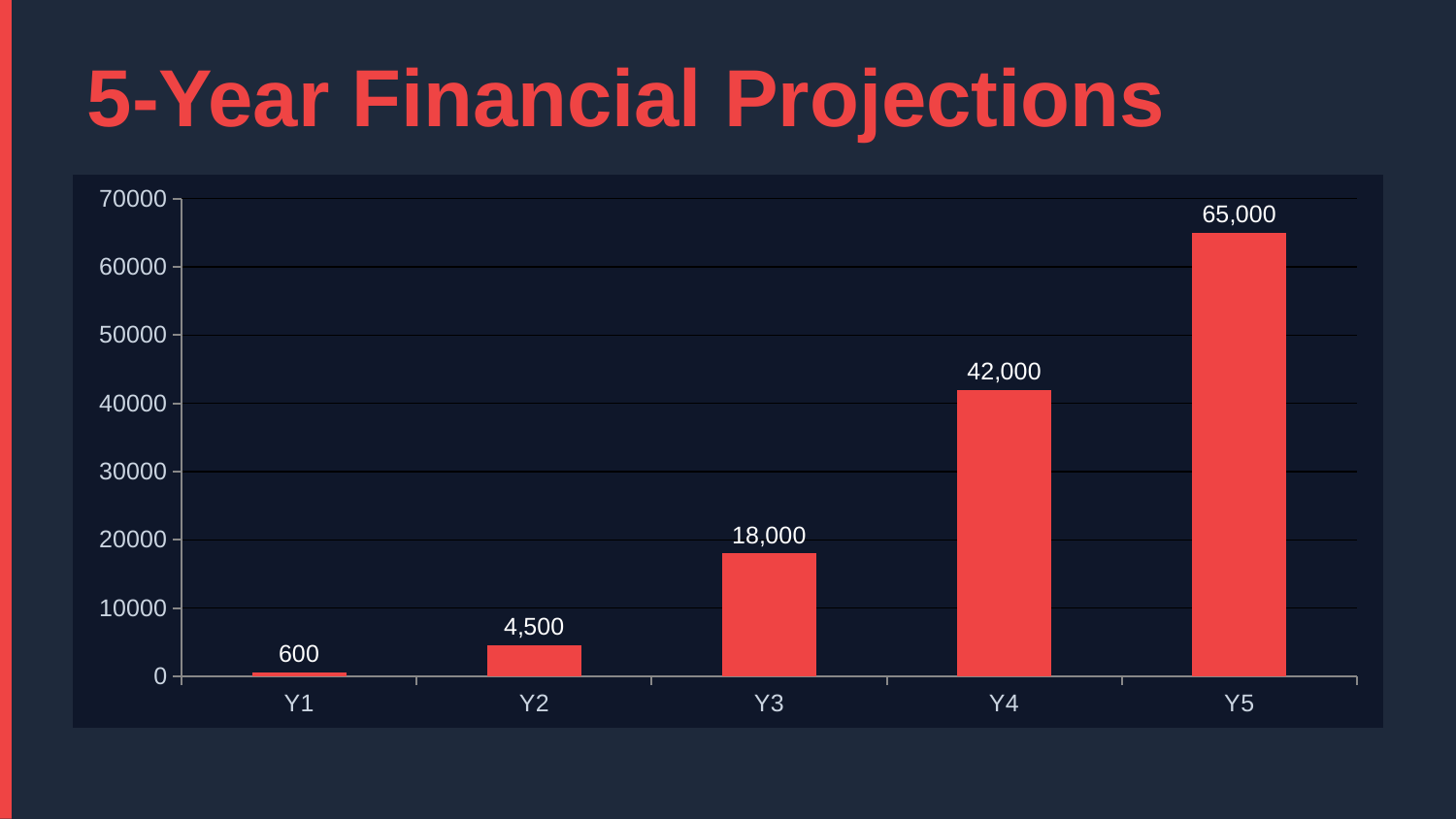
Which year has the highest value? Y5 Which is larger, the value for Y2 or the value for Y3? Y3 Is the value for Y4 greater or less than 40000? greater Do the values rise or fall from Y1 to Y5? Rise What is the value for Y4? 42,000 How many years are shown on the x axis? 5 What kind of chart is shown on the slide? Bar chart What is the value for Y1? 600 What is the difference between the values for Y5 and Y4? 23,000 Which year has the lowest value? Y1 What is the value for Y3? 18,000 What is the difference between the values for Y2 and Y1? 3,900